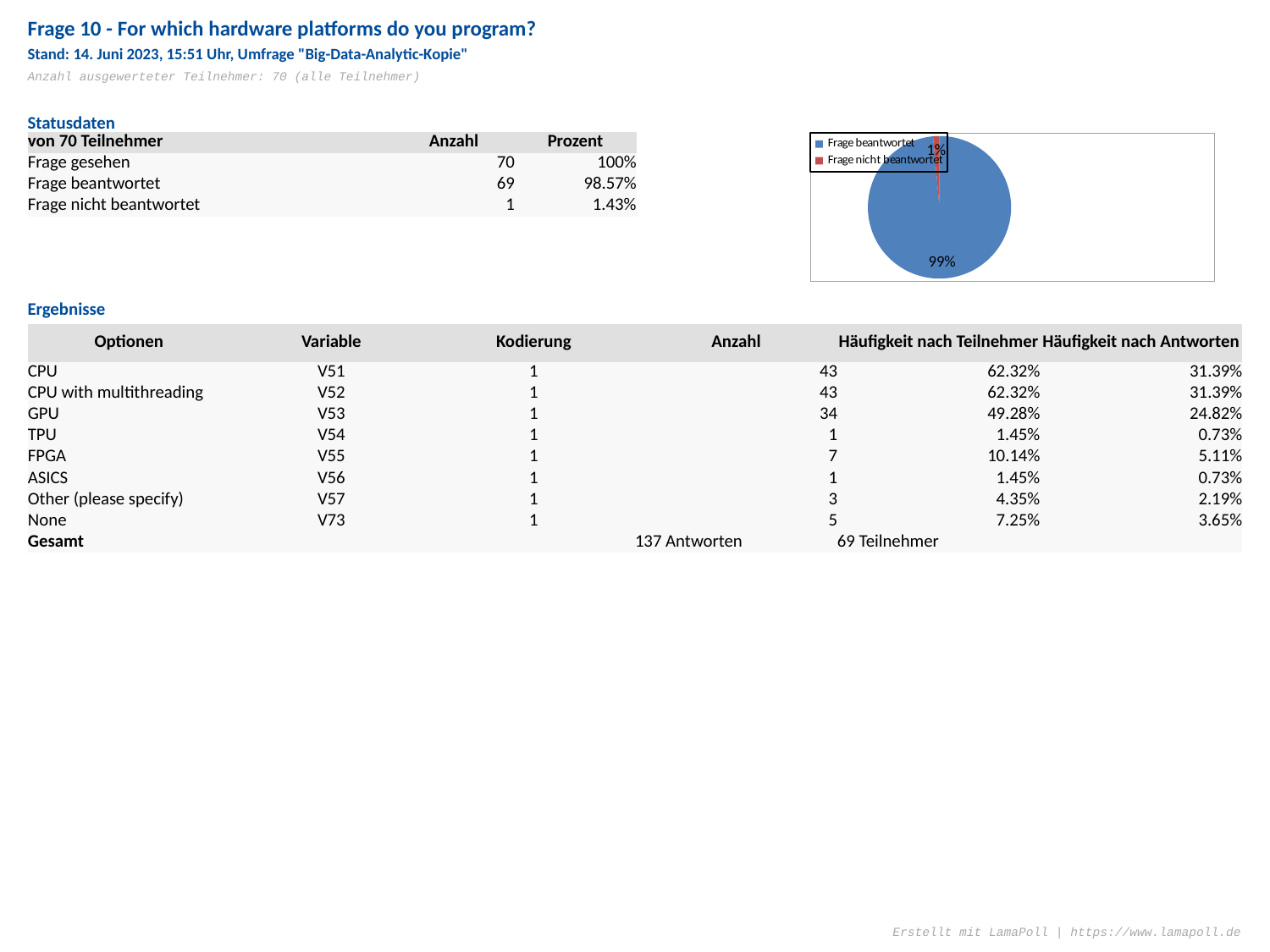
What colour is the "Frage nicht beantwortet" slice in the pie chart? red What kind of chart is shown on the slide? pie chart How many series does the legend of the pie chart list? 2 Which slice of the pie chart is the largest? Frage beantwortet What is the difference in percentage points between the "Frage beantwortet" and "Frage nicht beantwortet" slices? 98 Which slice of the pie chart is the smallest? Frage nicht beantwortet What share of the pie does "Frage beantwortet" have? 99% What colour is the "Frage beantwortet" slice in the pie chart? blue How many slices does the pie chart have? 2 Which is larger in the pie chart, "Frage beantwortet" or "Frage nicht beantwortet"? Frage beantwortet What share of the pie does "Frage nicht beantwortet" have? 1%